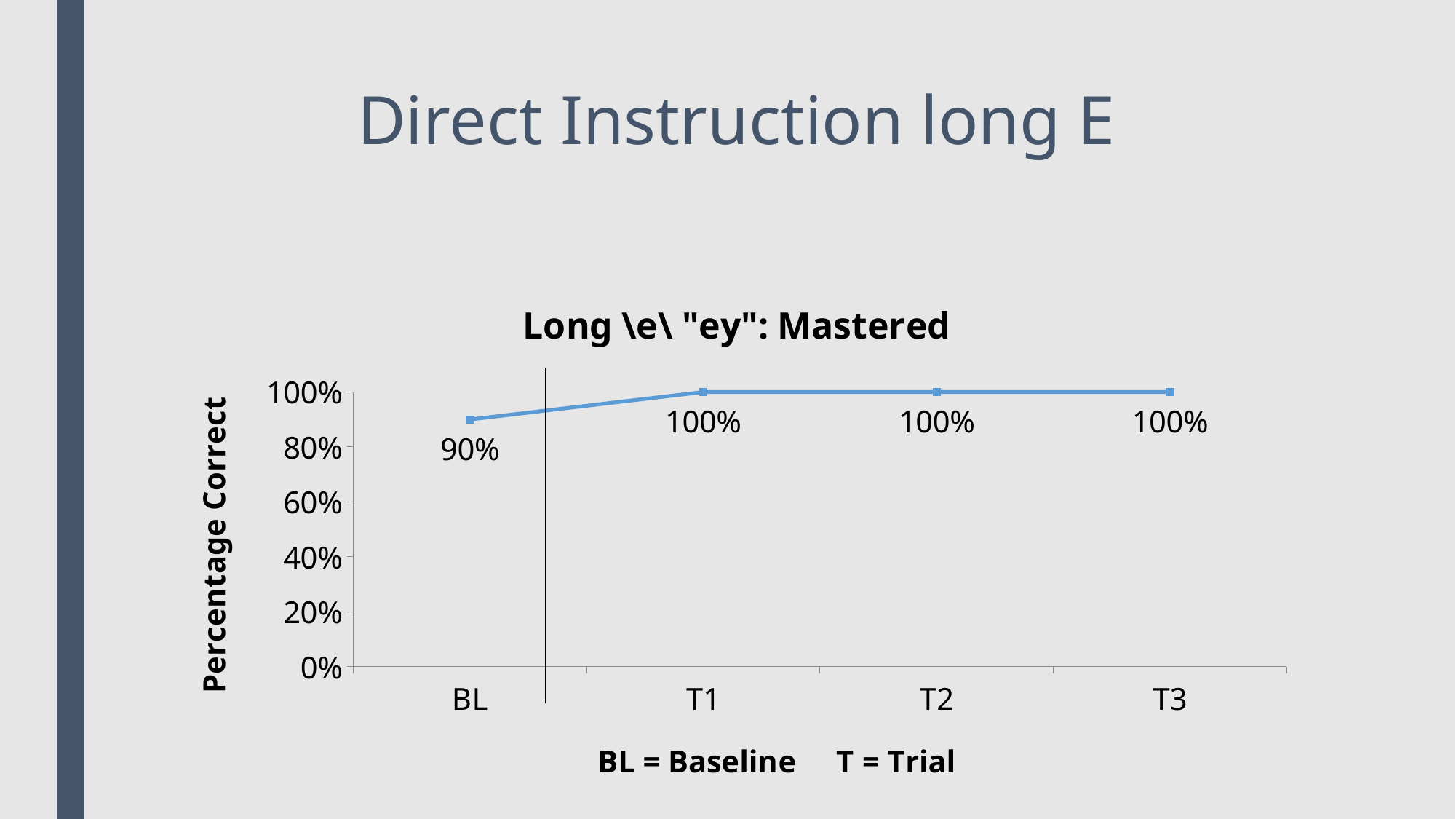
What kind of chart is this? line chart Do the values rise or fall from BL to T1? rise What is the value for T3? 100% Which category has the lowest value? BL Is the value for BL greater or less than 80%? greater What is the label of the y axis? Percentage Correct What is the value for BL? 90% What is the value for T1? 100% Which is larger, the value for BL or the value for T2? T2 What is the difference between the values for T1 and BL? 10% How many categories are shown on the x axis? 4 What is the title of the chart? Long \e\ "ey": Mastered